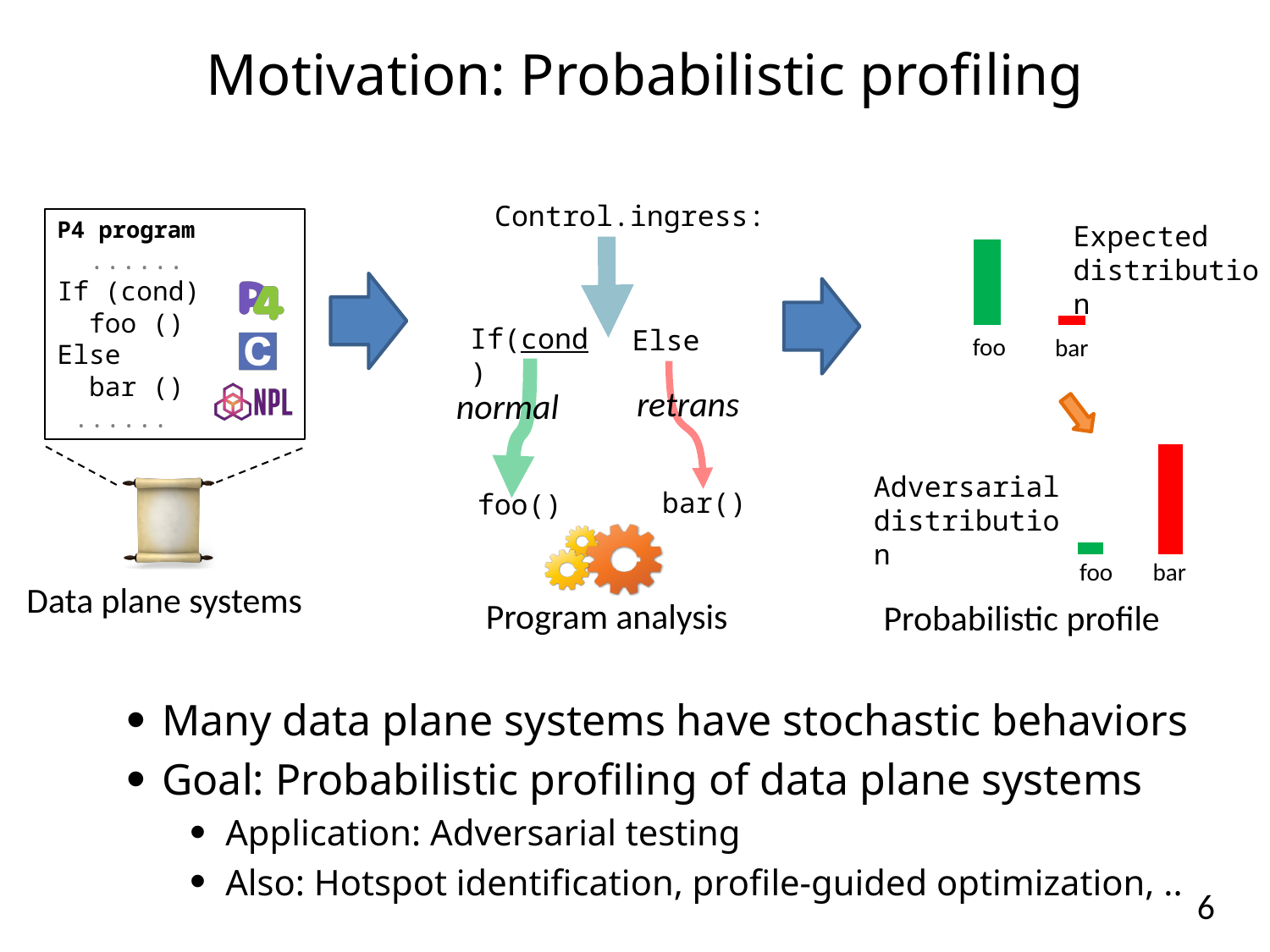
In the Adversarial distribution chart, which category has the shorter bar? foo In the Expected distribution chart, which category has the shorter bar? bar In the Expected distribution chart, is the bar for foo taller or shorter than the bar for bar? taller What kind of chart is the Adversarial distribution chart? bar chart How many categories are shown in the Expected distribution chart? 2 In the Adversarial distribution chart, what colour is the bar for the category bar? red In the Adversarial distribution chart, which category has the taller bar? bar What kind of chart is the Expected distribution chart? bar chart In the Expected distribution chart, what colour is the bar for foo? green In the Expected distribution chart, which category has the taller bar? foo In the Adversarial distribution chart, is the bar for foo taller or shorter than the bar for bar? shorter How many categories are shown in the Adversarial distribution chart? 2